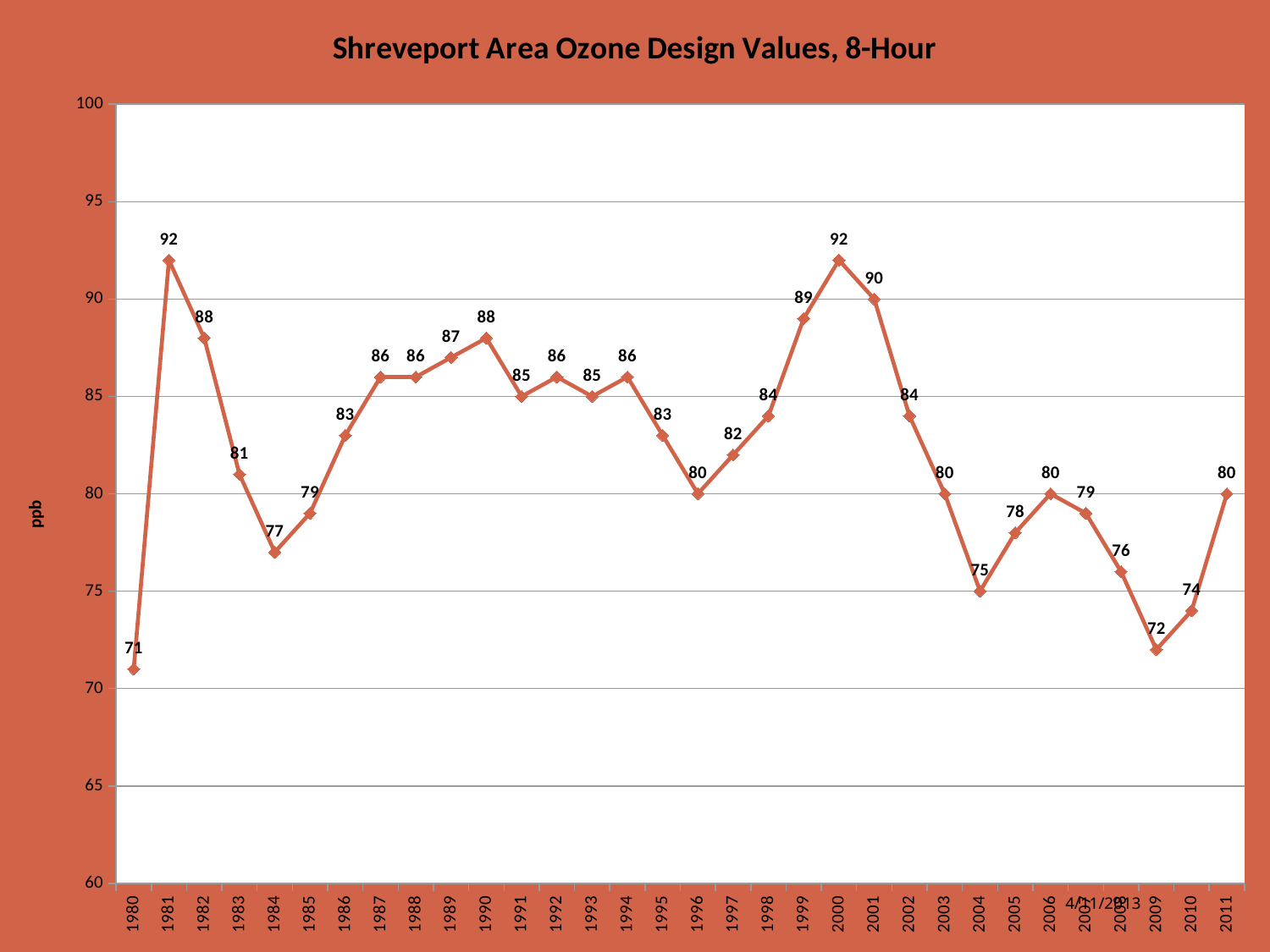
Which year has a larger value, 1986 or 2002? 2002 What is the ozone design value for 1999? 89 Which year has the lowest ozone design value? 1980 What is the label on the vertical axis? ppb Is the value for 2001 greater or less than 85? greater What is the highest ozone design value shown on the chart? 92 What is the difference between the values for 2000 and 2009? 20 Do the values rise or fall from 2006 to 2009? fall What type of chart is shown on the slide? line chart What is the ozone design value for 1990? 88 What is the ozone design value for 2004? 75 What is the difference between the values for 1981 and 1980? 21